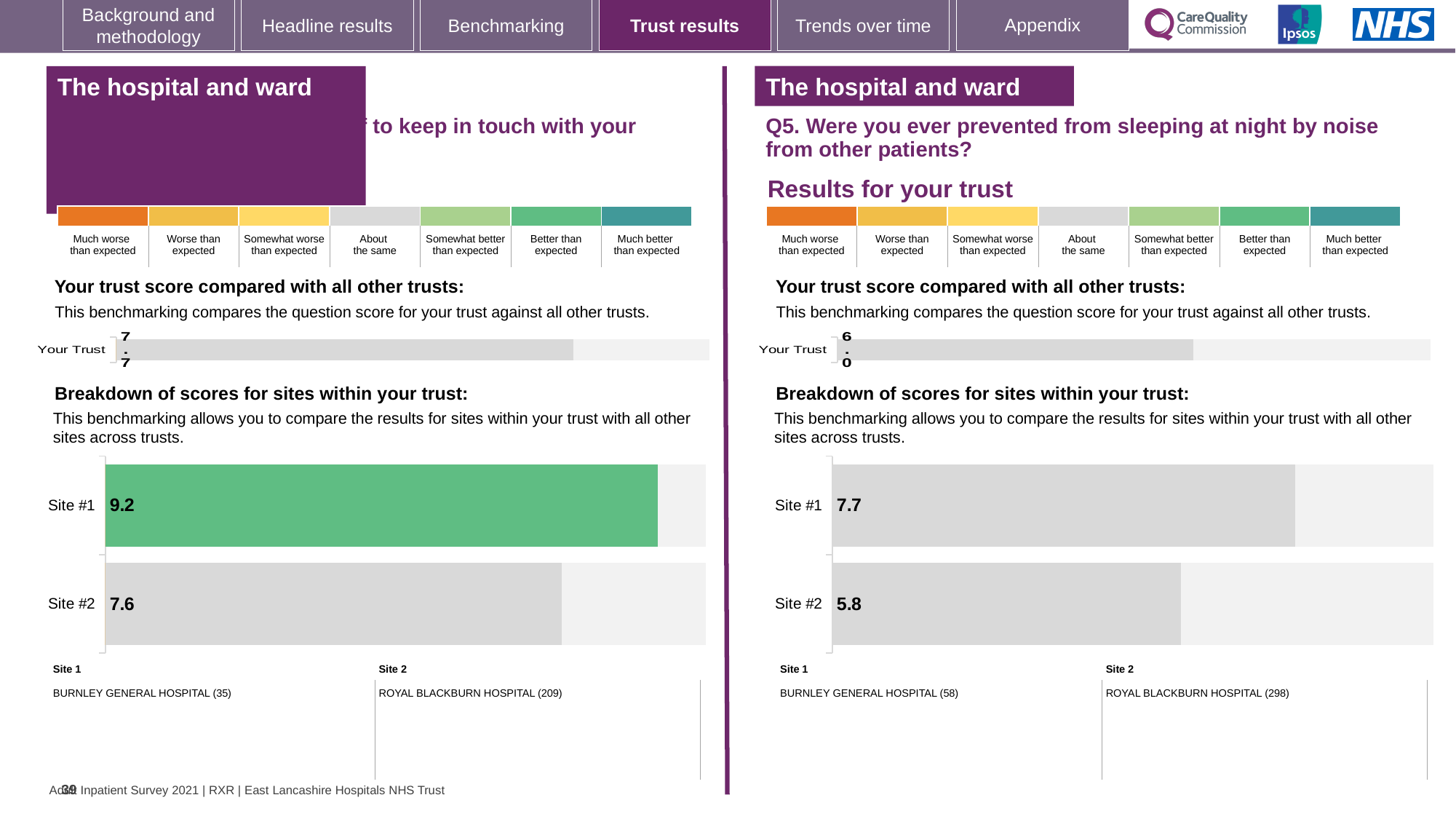
On the left-hand site breakdown chart, which site has the lower score? Site #2 On the left-hand site breakdown chart, what is the difference between the Site #1 and Site #2 scores? 1.6 On the left-hand site breakdown chart, what is the score for Site #1? 9.2 On the right-hand side for Q5, what is the 'Your Trust' score compared with all other trusts? 6.0 What type of chart is used for the site breakdown on the right-hand side for Q5? Bar chart On the right-hand chart for Q5, which site has the higher score? Site #1 On the right-hand chart for Q5, what is the difference between the Site #1 and Site #2 scores? 1.9 On the left-hand side, what is the 'Your Trust' score compared with all other trusts? 7.7 On the left-hand site breakdown chart, what is the score for Site #2? 7.6 On the right-hand chart for Q5, what is the score for Site #2? 5.8 On the right-hand chart for Q5 (prevented from sleeping by noise from other patients), what is the score for Site #1? 7.7 How many sites are shown in the right-hand site breakdown chart for Q5? 2